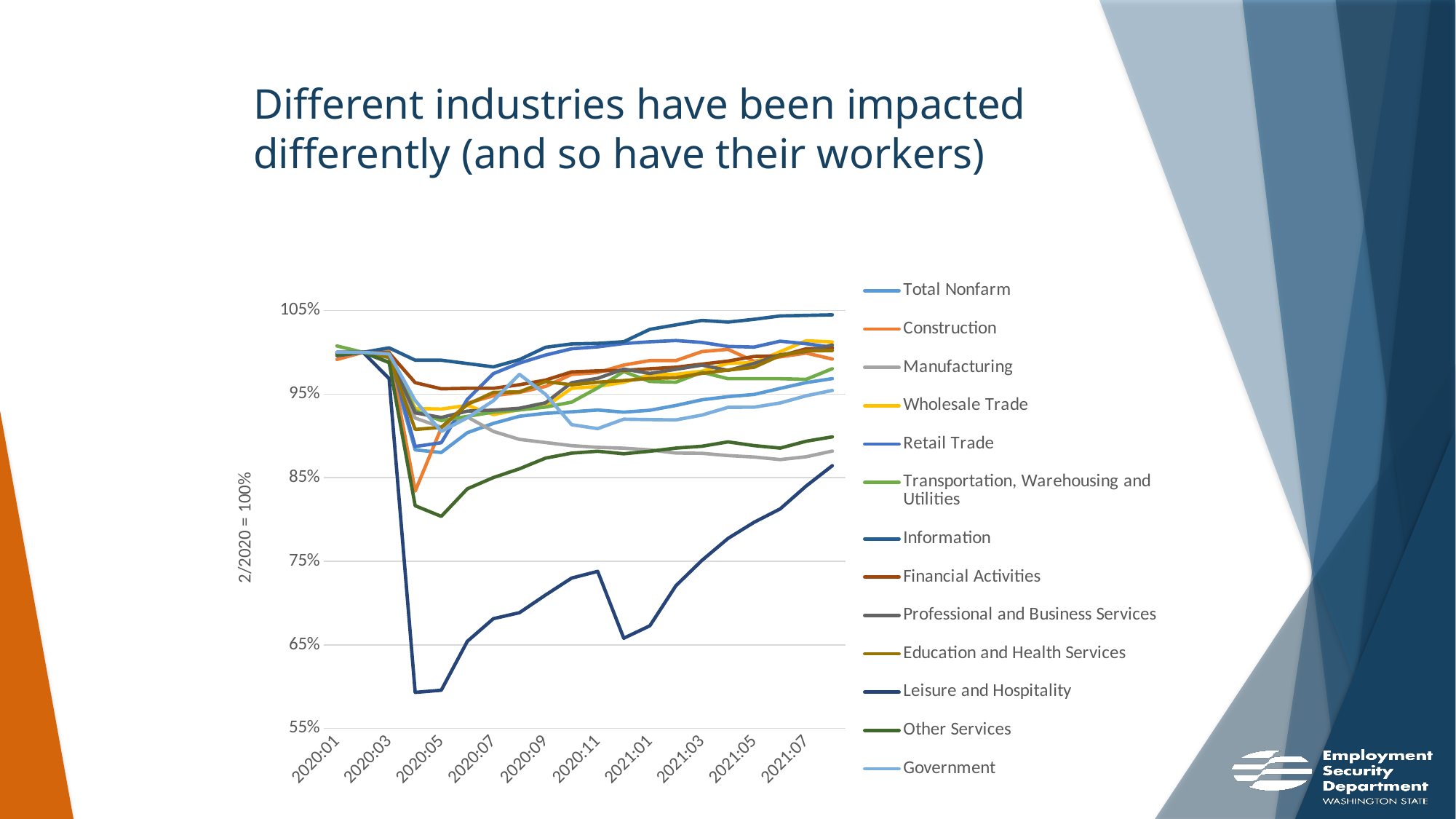
What is the y-axis title of the chart? 2/2020 = 100% Is the value for Leisure and Hospitality at 2020:04 greater or less than 65%? less Is the value for Manufacturing at 2021:07 greater or less than 95%? less Is the value for Information at 2021:07 greater or less than 95%? greater Does the Leisure and Hospitality line rise or fall from 2021:01 to 2021:07? rise Which is larger at 2021:07, Information or Manufacturing? Information Which series falls to the lowest value on the chart? Leisure and Hospitality What kind of chart is shown on the slide? line chart Which series has the highest value at 2021:07? Information What is the highest value labelled on the y axis? 105% How many series does the legend list? 13